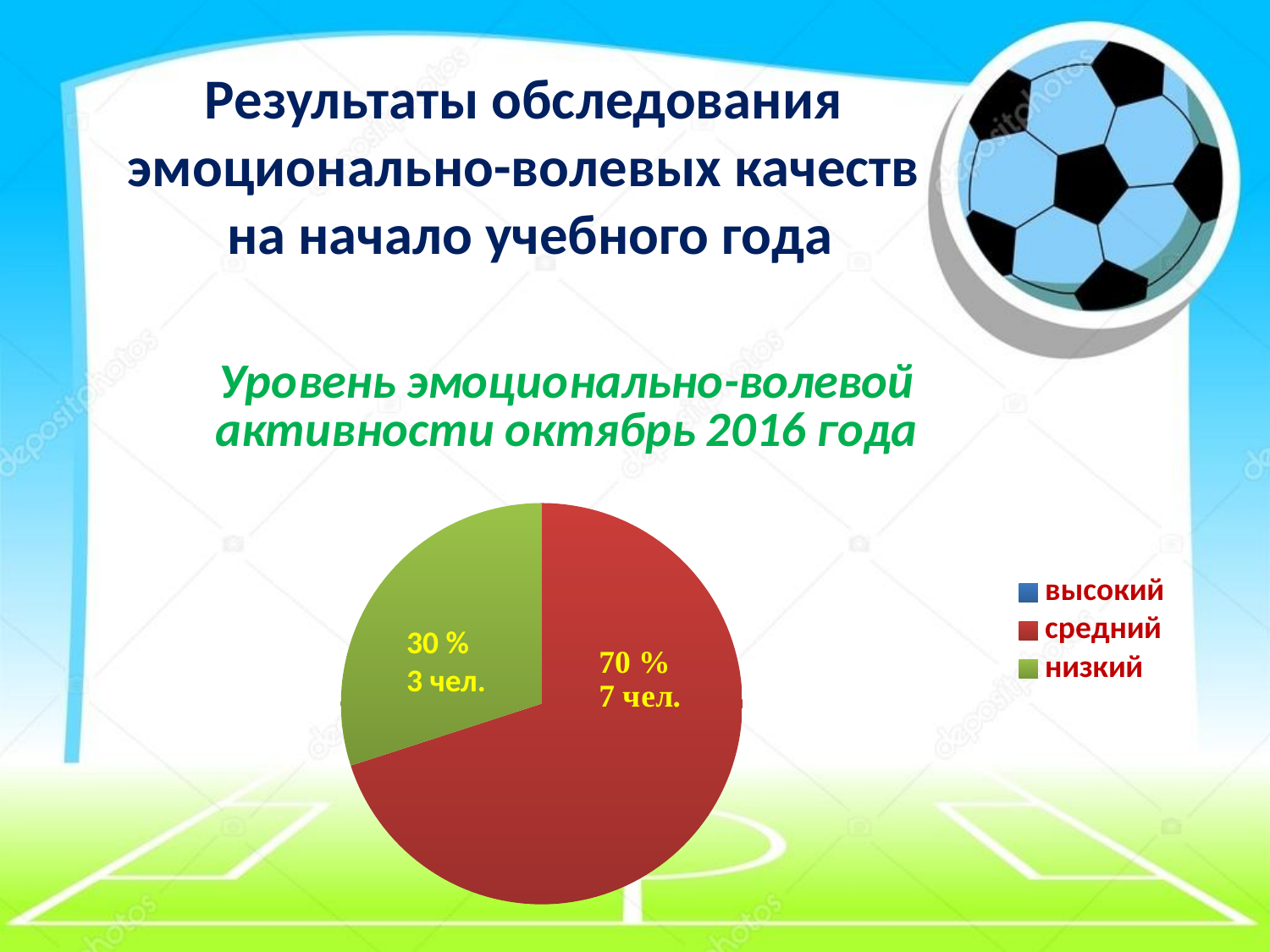
Which category has the largest slice of the pie? средний What is the chart's title? Уровень эмоционально-волевой активности октябрь 2016 года How many people (чел.) are in the "низкий" category? 3 чел. Which of the two visible slices is larger, "средний" or "низкий"? средний What colour is the "низкий" slice in the pie chart? green How many people (чел.) are in the "средний" category? 7 чел. What kind of chart is shown on the slide? pie chart What percentage share does the "средний" slice have? 70 % How many entries does the legend list? 3 What is the difference in percentage points between the "средний" and "низкий" slices? 40 What percentage share does the "низкий" slice have? 30 % What is the difference in number of people between the "средний" and "низкий" categories? 4